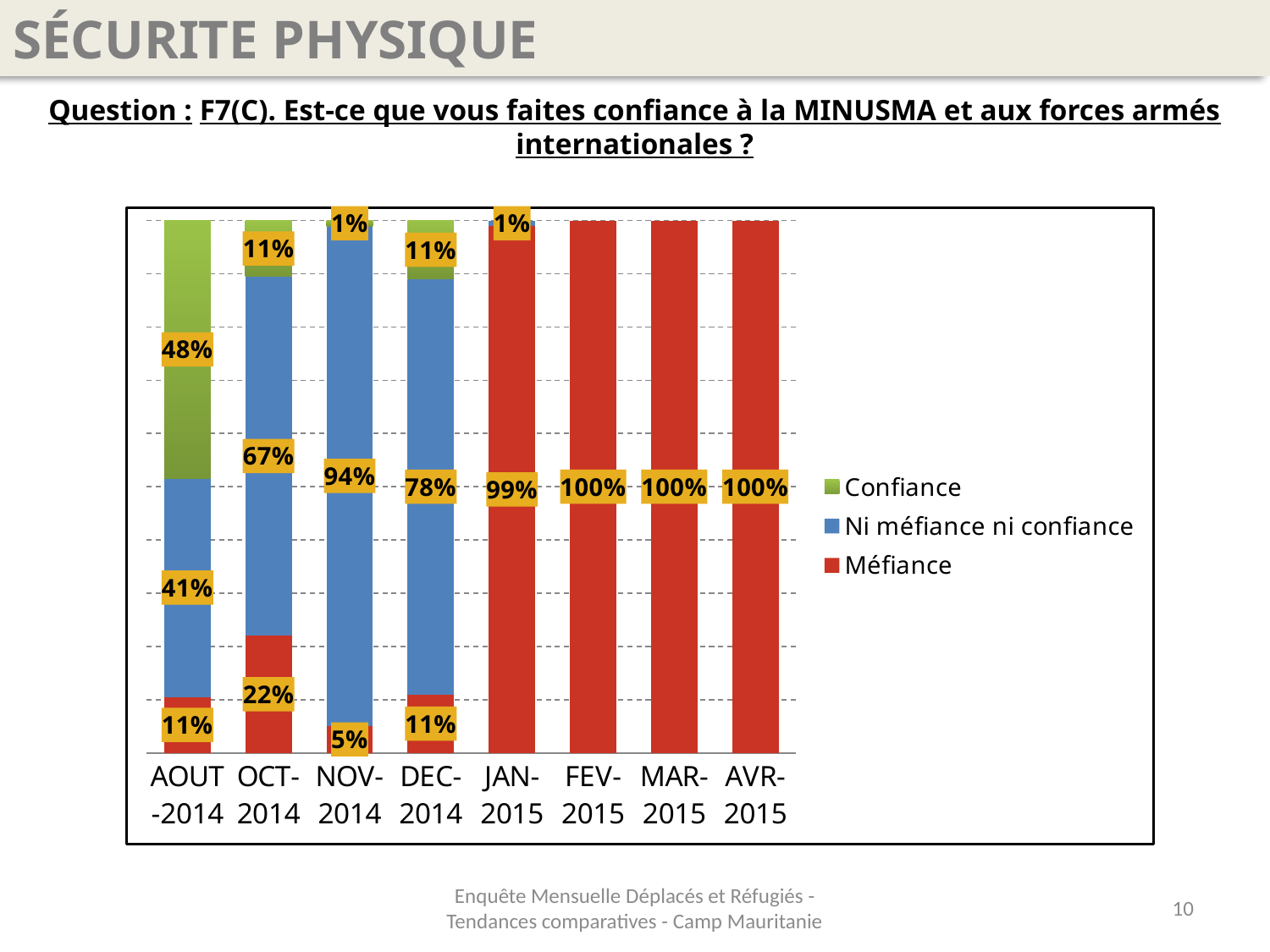
How many series does the legend list? 3 How many months are shown on the x axis? 8 What kind of chart is shown on the slide? Stacked bar chart What is the Ni méfiance ni confiance value for NOV-2014? 94% What is the Méfiance value for JAN-2015? 99% What is the difference between the Ni méfiance ni confiance values for DEC-2014 and OCT-2014? 11% Is the Méfiance value larger for OCT-2014 or for DEC-2014? OCT-2014 Which series is shown in red? Méfiance What is the Confiance value for AOUT-2014? 48% Which month has the highest Confiance value? AOUT-2014 Which month has the lowest Méfiance value? NOV-2014 What is the Méfiance value for OCT-2014? 22%